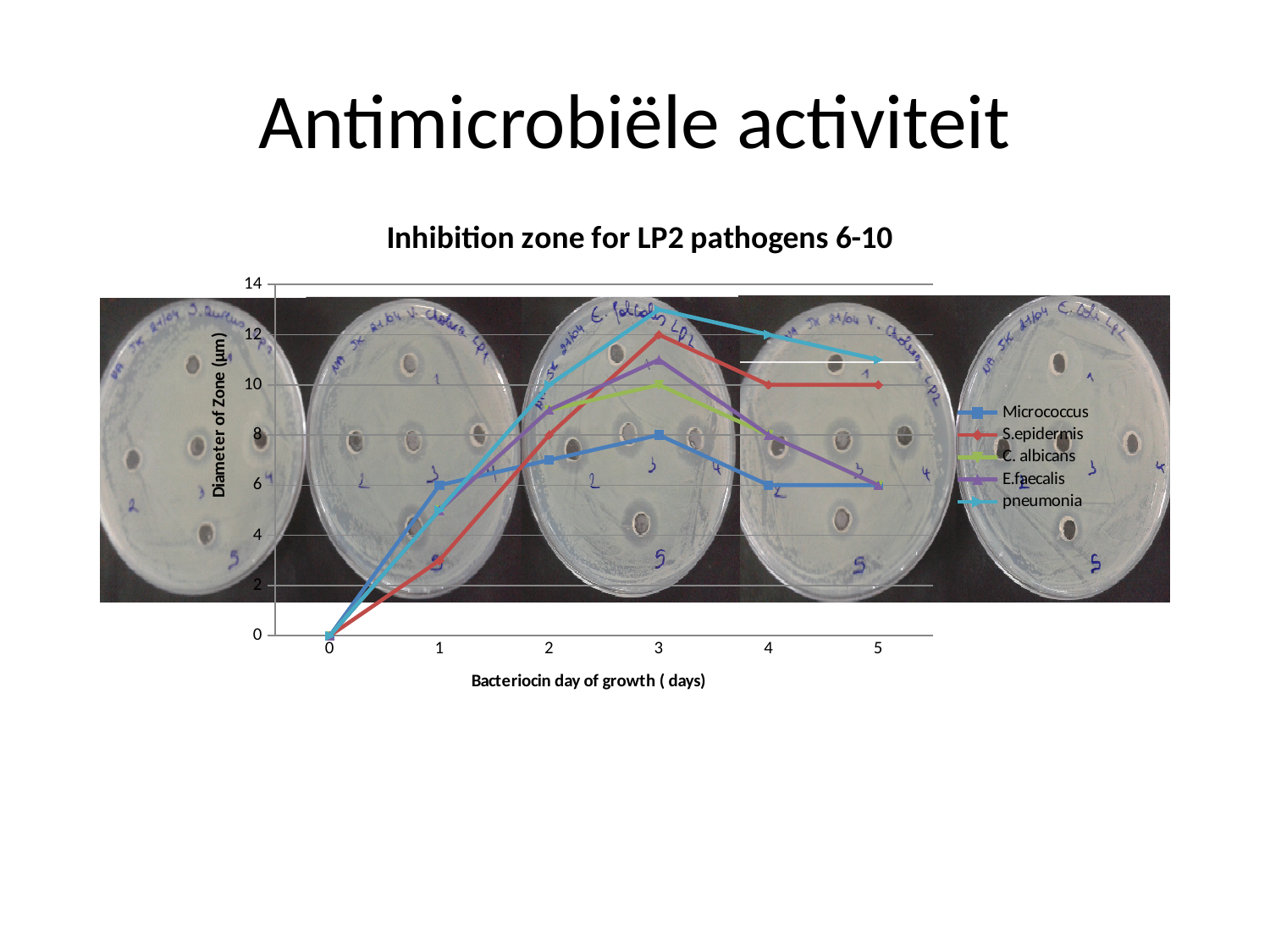
What is the label of the y axis? Diameter of Zone (µm) Is the value for S.epidermis at day 1 greater or less than 4? less At day 5, which is larger: S.epidermis or Micrococcus? S.epidermis Which series has the highest value at day 3? pneumonia What is the value for S.epidermis at day 4? 10 What kind of chart is shown on the slide? line chart Does the Micrococcus line rise or fall from day 3 to day 4? fall What is the title of the chart? Inhibition zone for LP2 pathogens 6-10 How many series does the legend list? 5 Which series has the lowest value at day 3? Micrococcus Is the value for pneumonia at day 3 greater or less than 12? greater How many day values are marked along the x axis? 6